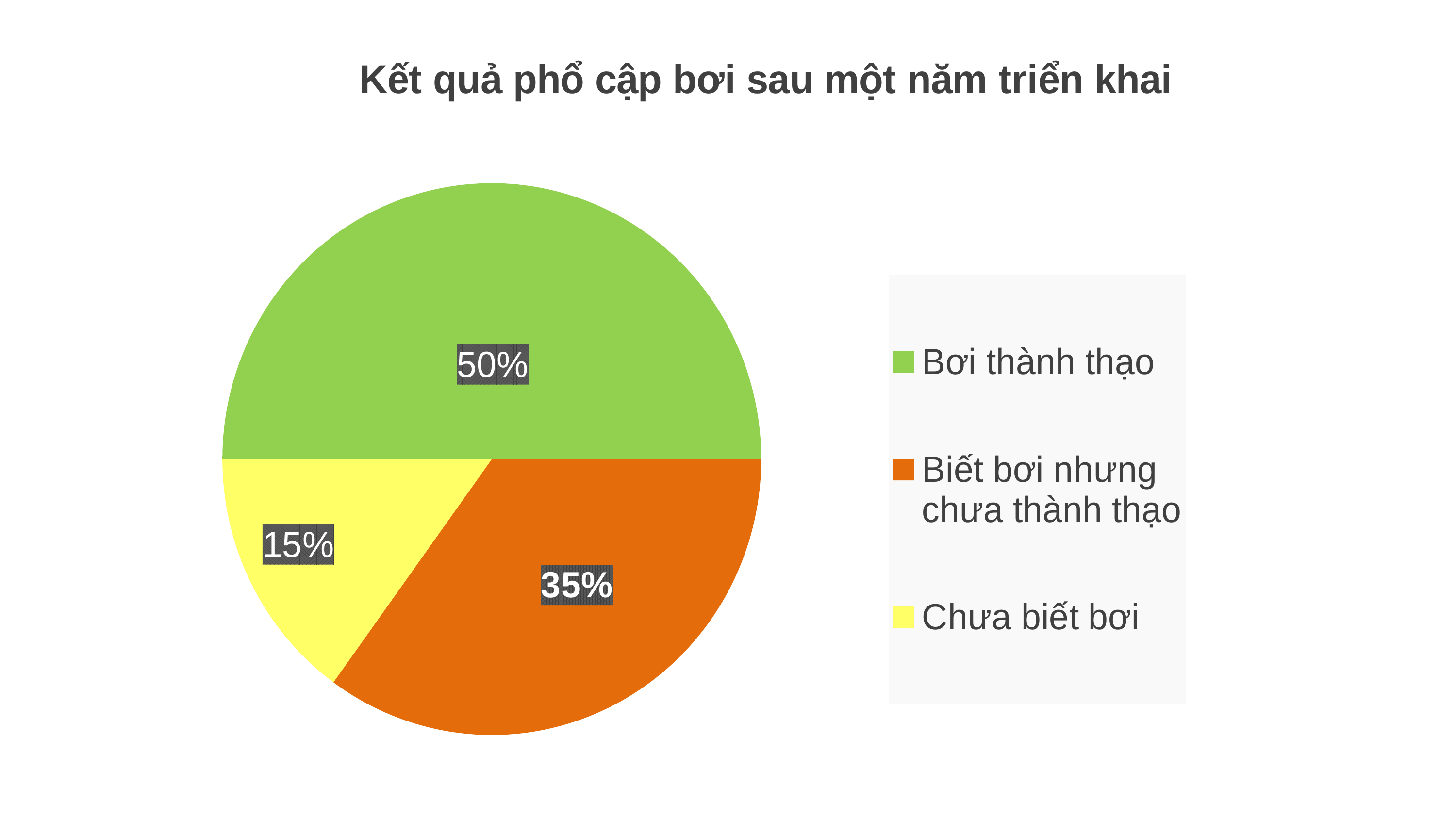
What is the title of the chart? Kết quả phổ cập bơi sau một năm triển khai What kind of chart is shown on the slide? pie chart How many entries does the legend list? 3 How many slices does the pie chart have? 3 What colour is the slice for Chưa biết bơi? yellow Which category has the smallest slice of the pie? Chưa biết bơi What percentage is shown for Bơi thành thạo? 50% What percentage is shown for Chưa biết bơi? 15% What percentage is shown for Biết bơi nhưng chưa thành thạo? 35% Which is larger, the slice for Biết bơi nhưng chưa thành thạo or the slice for Chưa biết bơi? Biết bơi nhưng chưa thành thạo What is the difference between the Bơi thành thạo and Chưa biết bơi percentages? 35% Which category has the largest slice of the pie? Bơi thành thạo